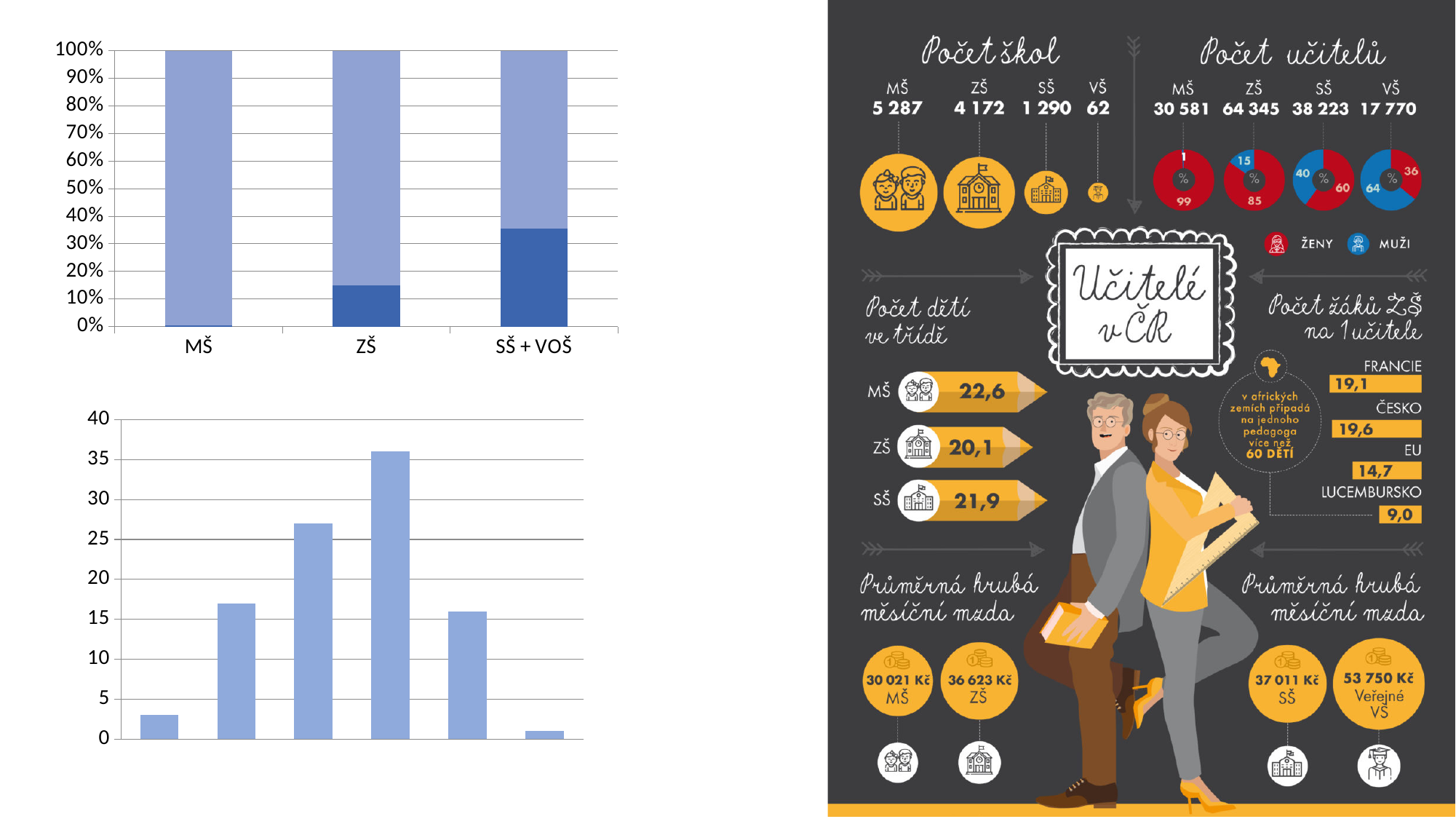
In the bottom chart on the left, do the values rise or fall from the first bar to the fourth bar? rise In the top stacked bar chart, which category has the smallest dark blue segment? MŠ In the bottom chart on the left, is the value of the third bar greater or less than 25? greater What kind of chart is the bottom chart on the left of the slide? bar chart In the top stacked bar chart, is the dark blue segment for SŠ + VOŠ greater or less than 30%? greater In the top stacked bar chart, which category has the largest dark blue segment? SŠ + VOŠ In the top stacked bar chart, is the dark blue segment for ZŠ greater or less than 20%? less In the top stacked bar chart, is the dark blue segment for ZŠ larger or smaller than the dark blue segment for SŠ + VOŠ? smaller What kind of chart is the top chart on the left of the slide? bar chart How many bars does the bottom chart on the left show? 6 In the bottom chart on the left, which bar is the tallest? the fourth bar How many categories does the top stacked bar chart show? 3